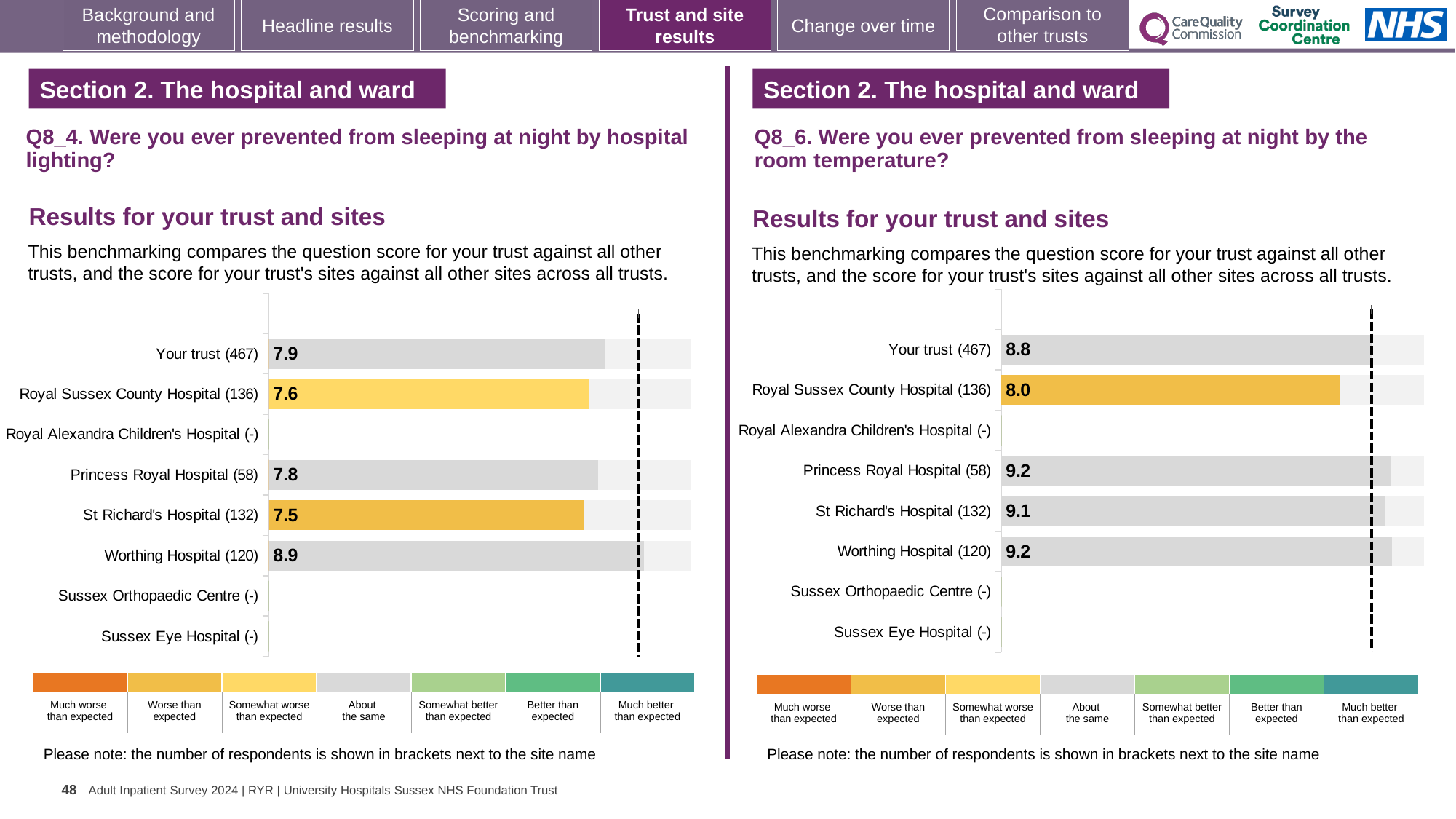
On the Q8_6 room temperature chart, which site has the lowest score? Royal Sussex County Hospital (136) On the Q8_6 room temperature chart, which is larger: the score for Your trust or the score for Princess Royal Hospital? Princess Royal Hospital On the Q8_4 hospital lighting chart, what is the score for Worthing Hospital (120)? 8.9 On the Q8_4 hospital lighting chart, what is the difference between the scores for Worthing Hospital and St Richard's Hospital? 1.4 How many sites (including Your trust) are listed on the Q8_4 hospital lighting chart? 8 On the Q8_6 room temperature chart, what is the score for Royal Sussex County Hospital (136)? 8.0 On the Q8_6 room temperature chart, what is the score for St Richard's Hospital (132)? 9.1 On the Q8_4 hospital lighting chart, what is the score for Your trust (467)? 7.9 On the Q8_6 room temperature chart, what is the difference between the scores for Your trust and Royal Sussex County Hospital? 0.8 What kind of chart is used on the Q8_6 room temperature chart? Bar chart On the Q8_4 hospital lighting chart, which site has the lowest score? St Richard's Hospital (132) On the Q8_4 hospital lighting chart, which site has the highest score? Worthing Hospital (120)